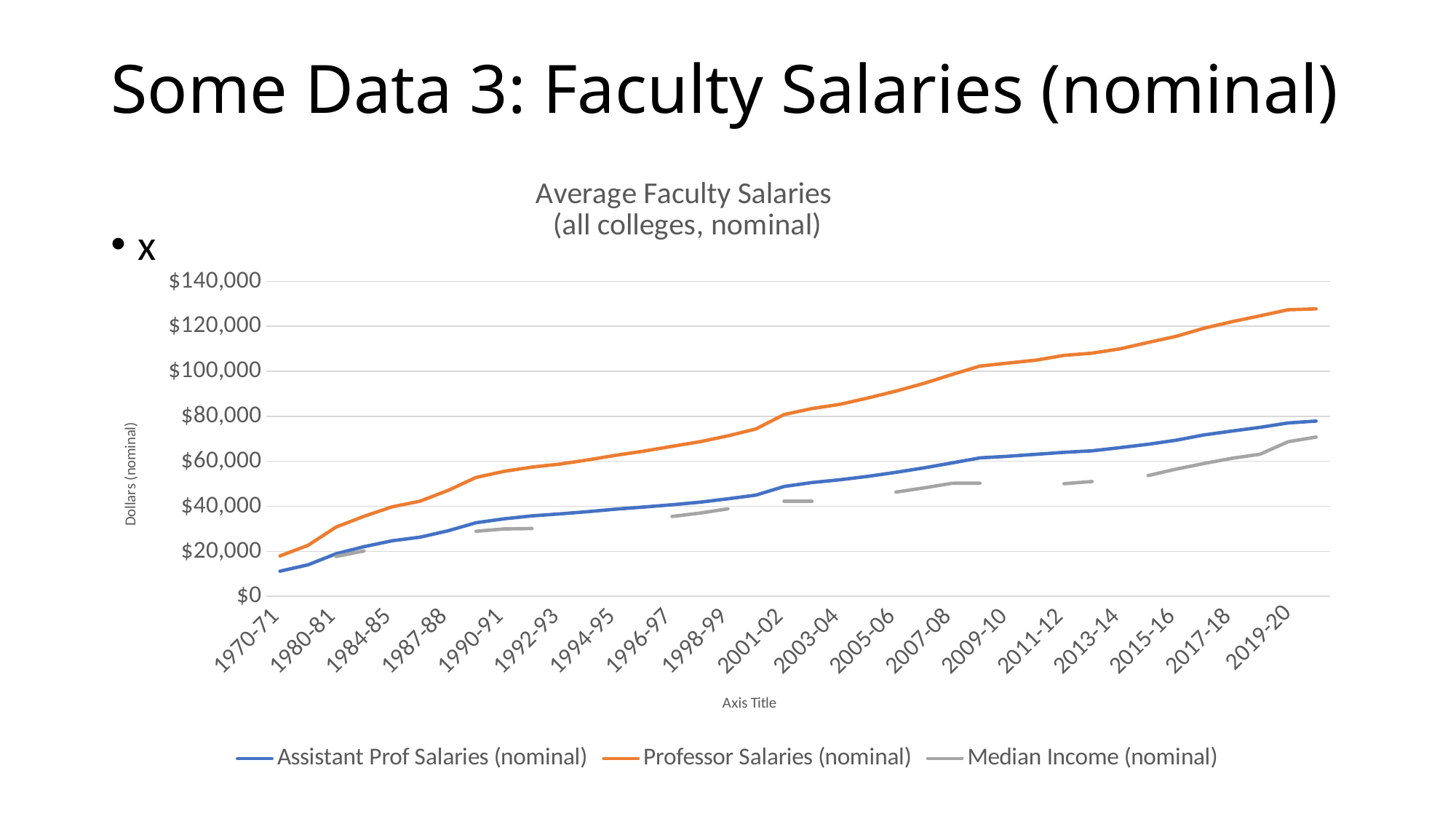
Is the value for Assistant Prof Salaries (nominal) in 2019-20 greater or less than $60,000? greater What is the title of the chart? Average Faculty Salaries (all colleges, nominal) What kind of chart is shown on the slide? line chart In 2019-20, which is larger: Professor Salaries (nominal) or Assistant Prof Salaries (nominal)? Professor Salaries (nominal) Is the value for Professor Salaries (nominal) in 1990-91 greater or less than $40,000? greater Is the value for Assistant Prof Salaries (nominal) in 1970-71 greater or less than $20,000? less Which series has the highest values across the chart? Professor Salaries (nominal) Do Professor Salaries (nominal) rise or fall from 1970-71 to 2019-20? rise How many series does the legend list? 3 What is the label on the vertical axis? Dollars (nominal)